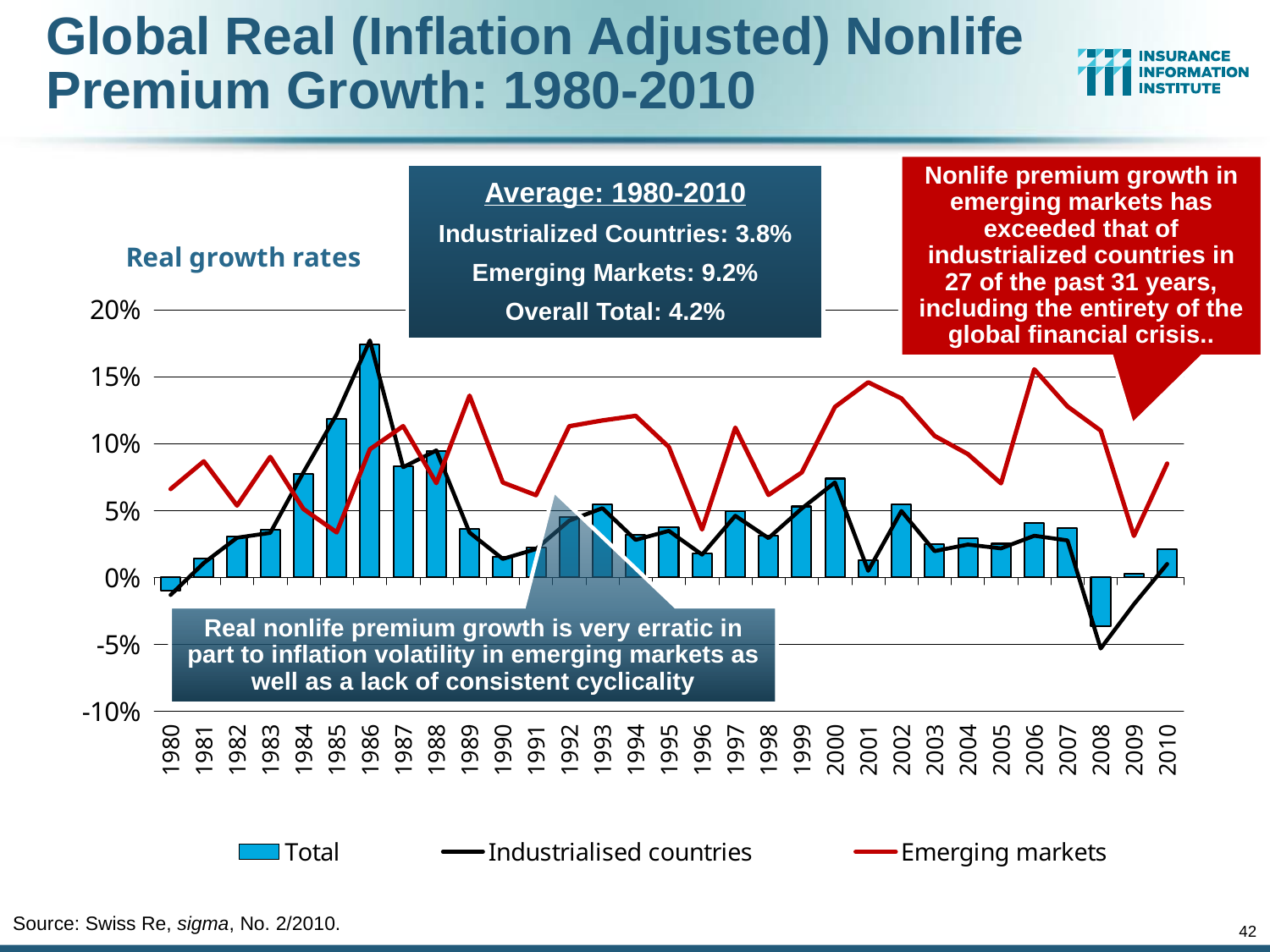
Which is larger in 2009, the Emerging markets value or the Industrialised countries value? Emerging markets Which series is drawn as a red line? Emerging markets Is the Total value for 2008 greater or less than 0%? less What kind of chart is shown on the slide? combination bar and line chart Is the Industrialised countries value for 1986 greater or less than 15%? greater Is the Emerging markets value for 1996 greater or less than 5%? less How many years are shown along the x axis? 31 According to the text box on the chart, what is the 1980-2010 average growth for Emerging Markets? 9.2% In which year is the Total bar the highest? 1986 In which year is the Total bar the lowest? 2008 How many series does the legend list? 3